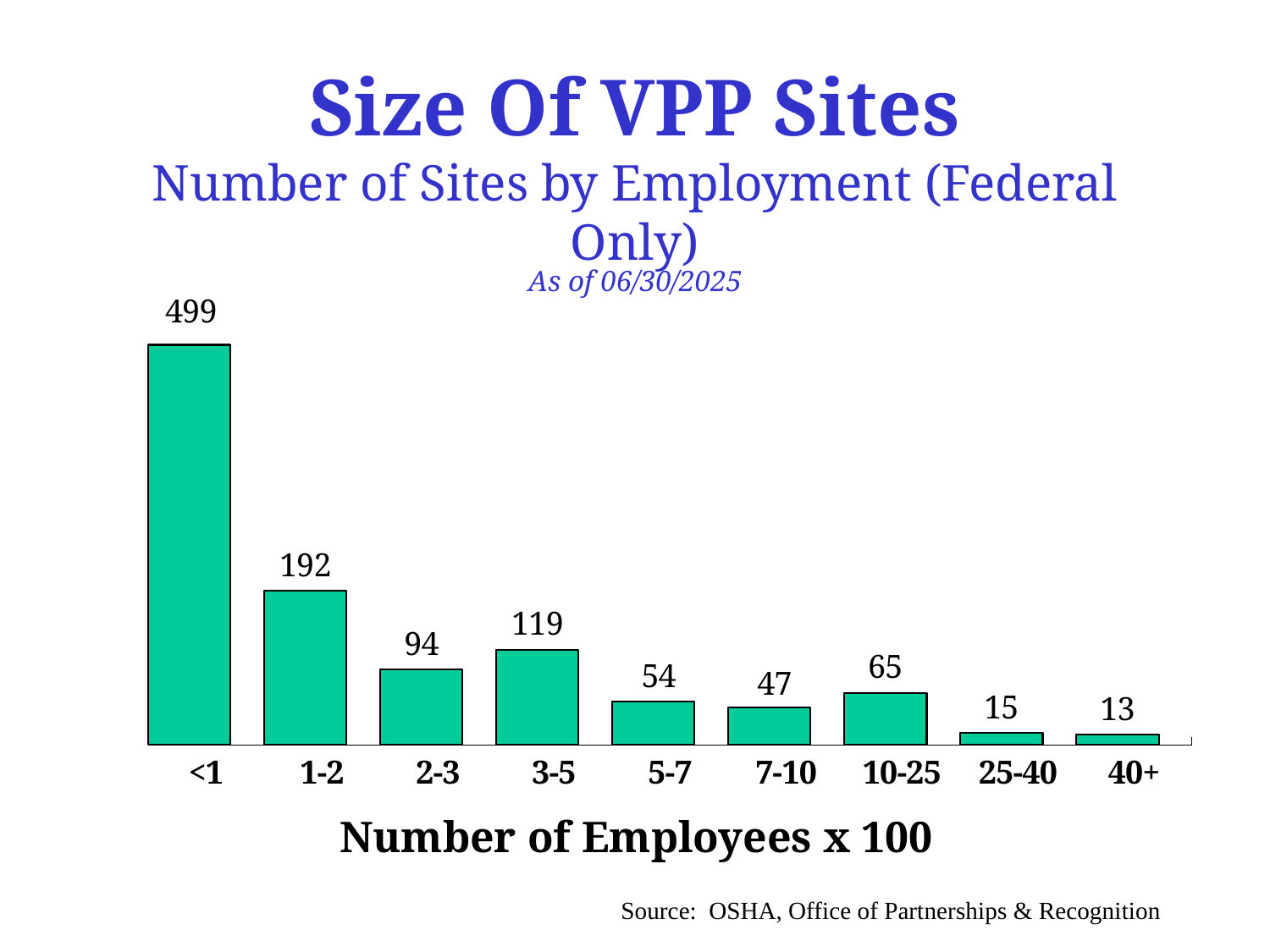
How many categories are shown on the x axis? 9 What kind of chart is shown on the slide? Bar chart What is the value for the 3-5 category? 119 What is the value for the 10-25 category? 65 What is the x-axis label of the chart? Number of Employees x 100 What is the difference between the values for <1 and 1-2? 307 Which category has the lowest number of sites? 40+ Which is larger, the value for 2-3 or the value for 3-5? 3-5 How many sites are in the <1 category? 499 Which is larger, the value for 5-7 or the value for 7-10? 5-7 What is the difference between the values for 3-5 and 2-3? 25 Which category has the highest number of sites? <1